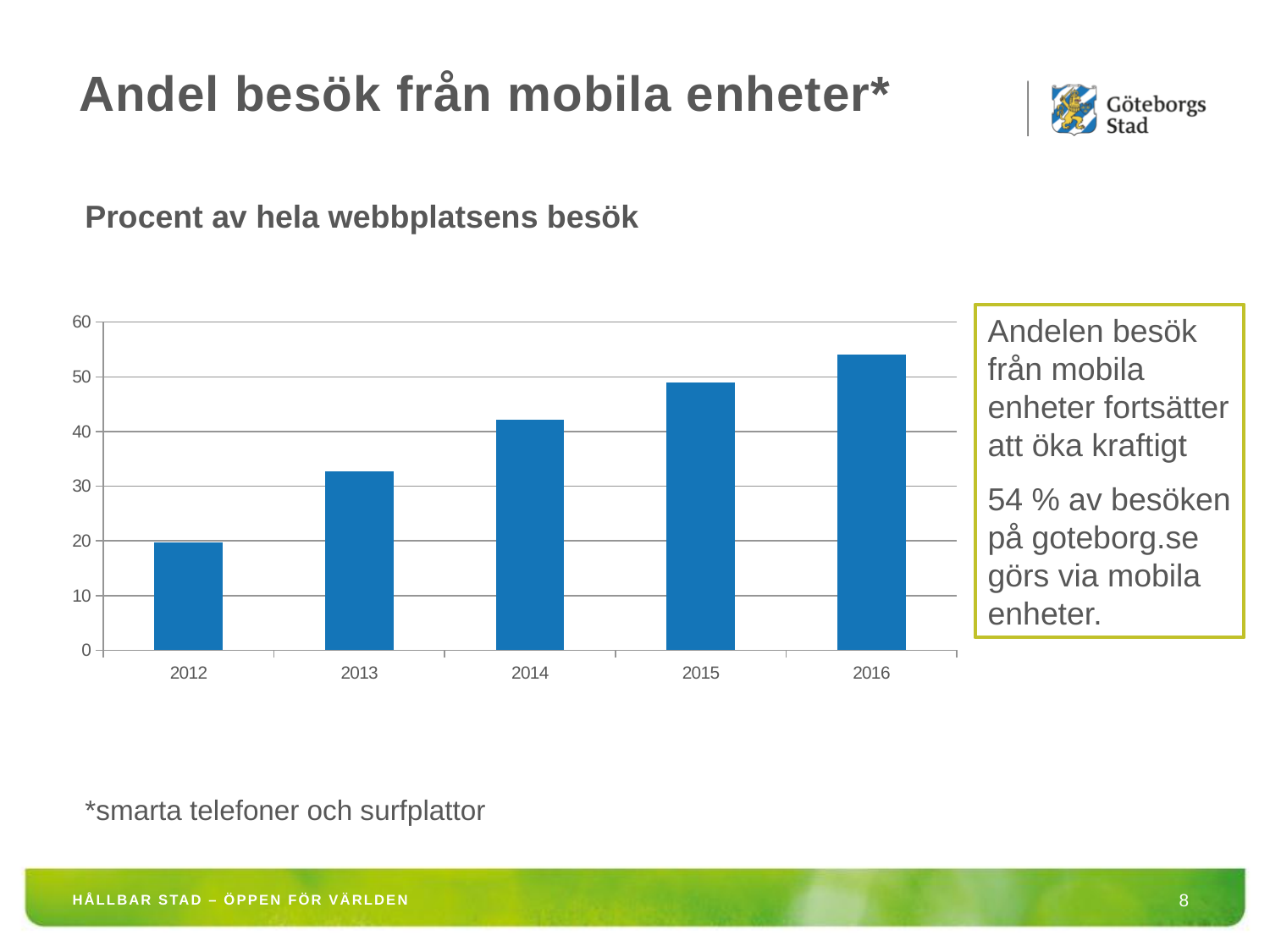
Is the value for 2014 greater or less than 40? greater Which year has the highest bar in the chart? 2016 What is the title of the slide containing the chart? Andel besök från mobila enheter* Is the value for 2016 greater or less than 50? greater Do the values rise or fall from 2012 to 2016? rise Which is larger, the value for 2013 or the value for 2015? 2015 What kind of chart is shown on the slide? bar chart Is the value for 2015 greater or less than 40? greater How many years are shown on the x axis of the chart? 5 Which year has the lowest bar in the chart? 2012